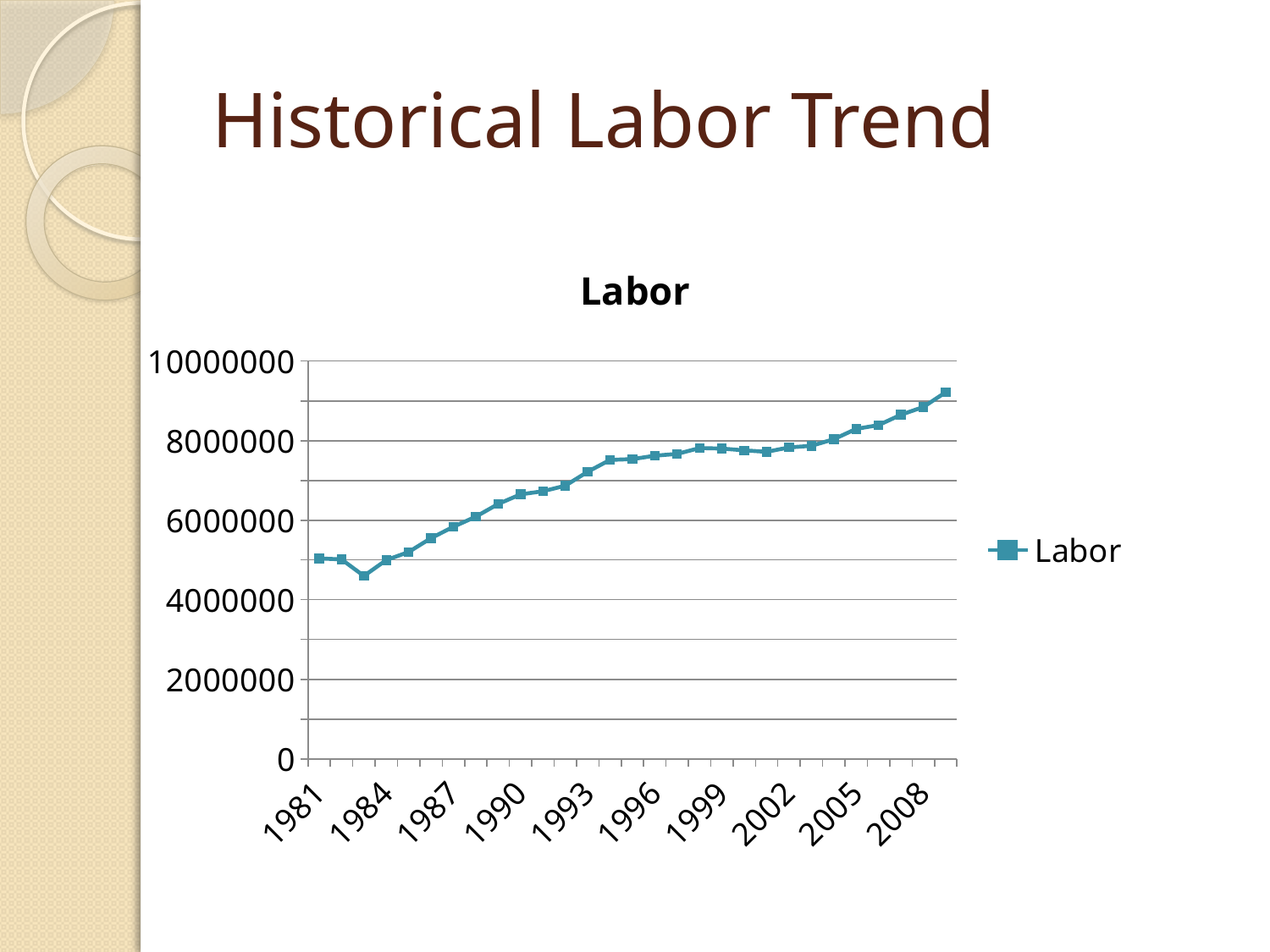
Which year has the larger Labor value, 1987 or 1999? 1999 Is the Labor value for 2008 greater or less than 8000000? greater Is the Labor value for 1990 greater or less than 6000000? greater How many series does the legend list? 1 Is the Labor value for 1981 greater or less than 6000000? less Overall, do the Labor values rise or fall from 1981 to the end of the series? rise What is the title of the chart? Labor Which year has the larger Labor value, 1981 or 2005? 2005 What kind of chart is shown on the slide? line chart What is the name of the series shown in the legend? Labor